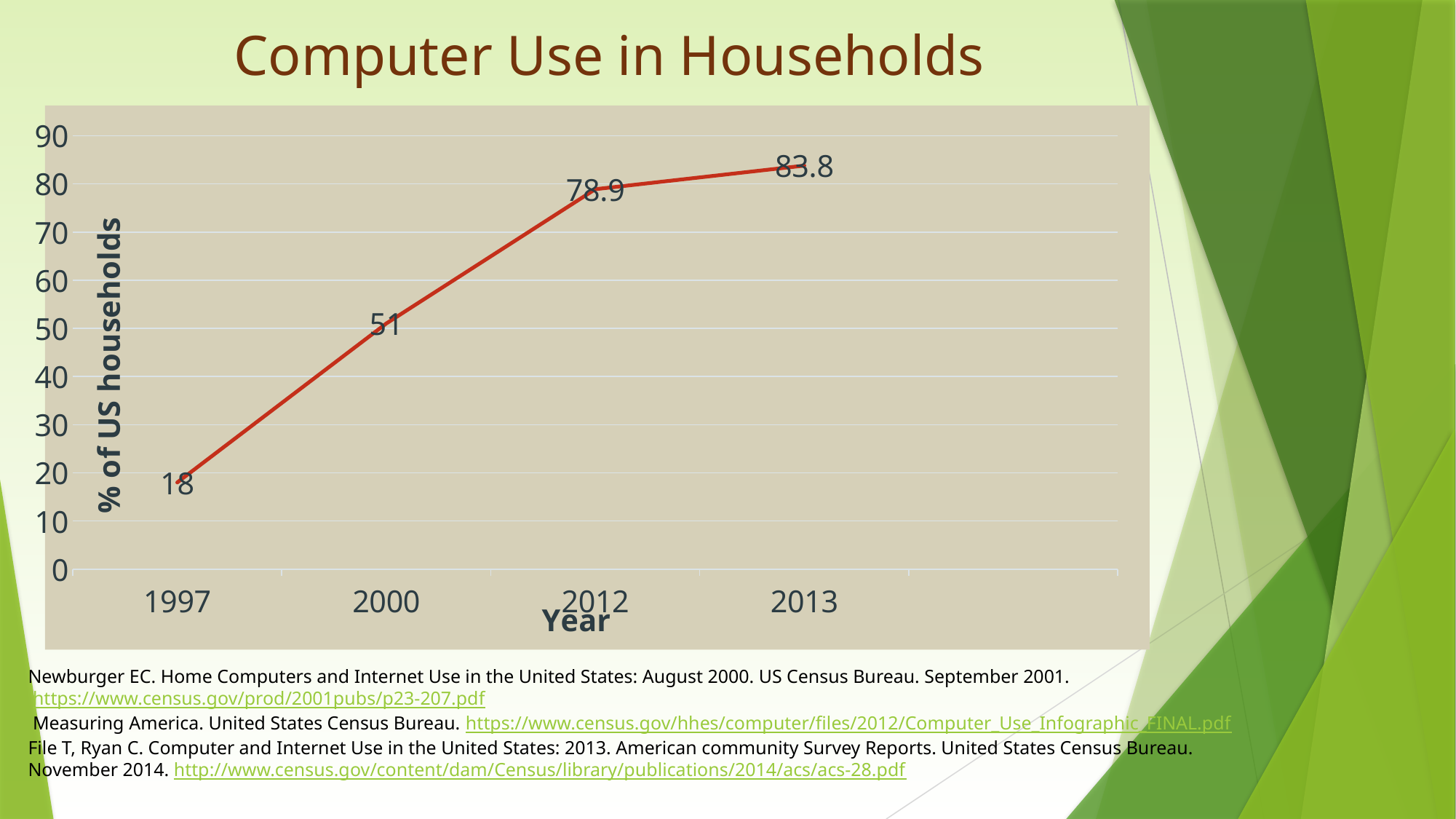
What is the difference between the values for 2013 and 2012? 4.9 What is the value plotted for the year 2012? 78.9 What is the difference between the values for 2000 and 1997? 33 How many years are plotted on the x axis? 4 Do the values rise or fall from 1997 to 2013? Rise What kind of chart is shown on the slide? Line chart What is the value plotted for the year 2000? 51 What percentage of US households used computers in 1997? 18 What is the value plotted for the year 2013? 83.8 Which year has a larger value, 2000 or 2012? 2012 Which year has the highest percentage of US households with computer use? 2013 Which year has the lowest percentage of US households with computer use? 1997